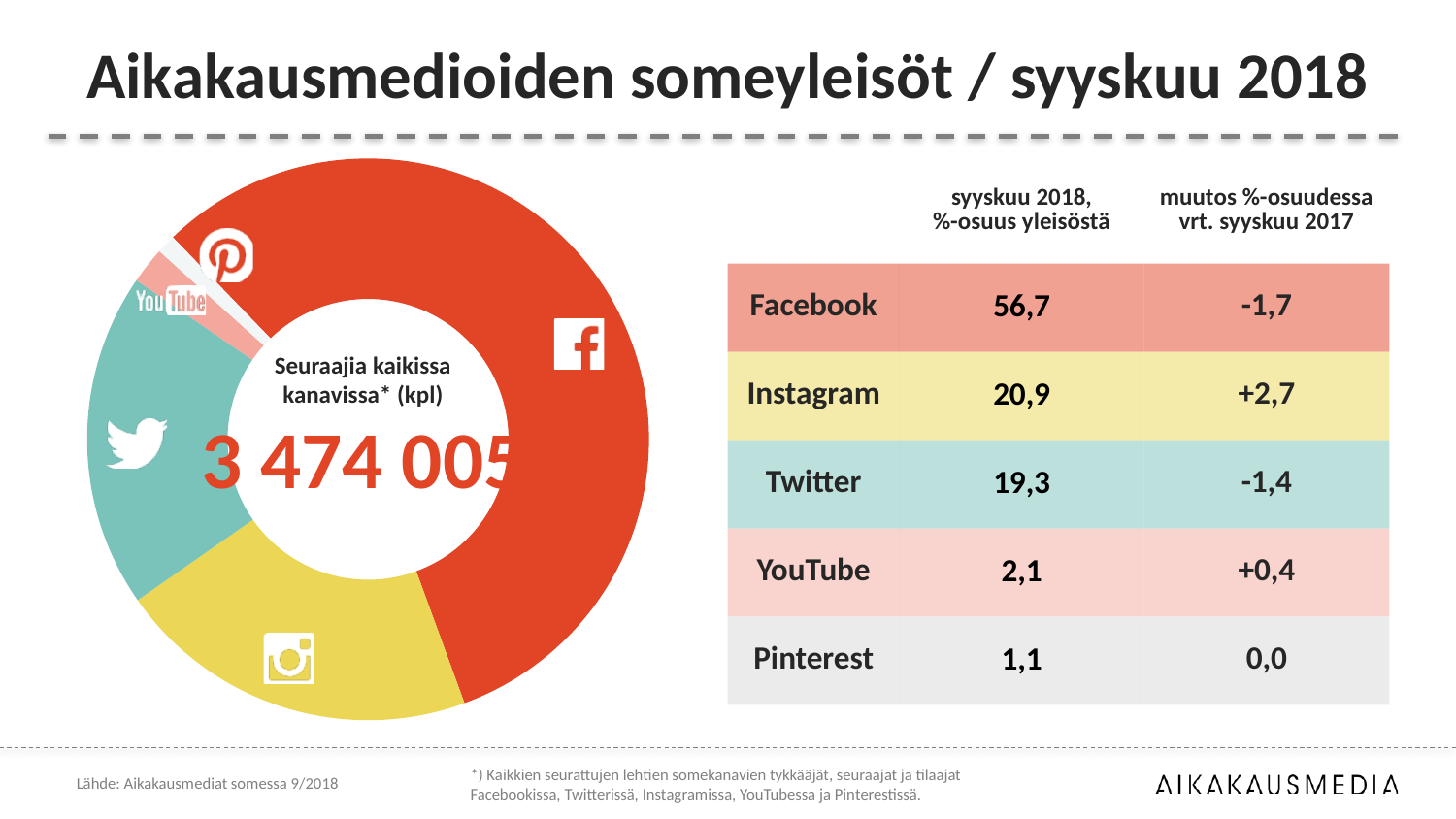
What is the change in Facebook's %-share compared with September 2017? -1,7 What is Facebook's share of the audience in September 2018 (%-osuus yleisöstä)? 56,7 What is the difference in percentage share between Facebook and Instagram? 35,8 What is the total number of followers across all channels shown in the centre of the pie chart? 3 474 005 How many social media channels are shown as slices in the pie chart? 5 What is Instagram's share of the audience in September 2018? 20,9 Which has a larger share of the audience, Instagram or Twitter? Instagram Which channel has the largest share of the audience in the pie chart? Facebook What kind of chart is shown on the left of the slide? doughnut chart What is the change in Instagram's %-share compared with September 2017? +2,7 Which channel has the smallest share of the audience in the pie chart? Pinterest What is the title of the slide? Aikakausmedioiden someyleisöt / syyskuu 2018